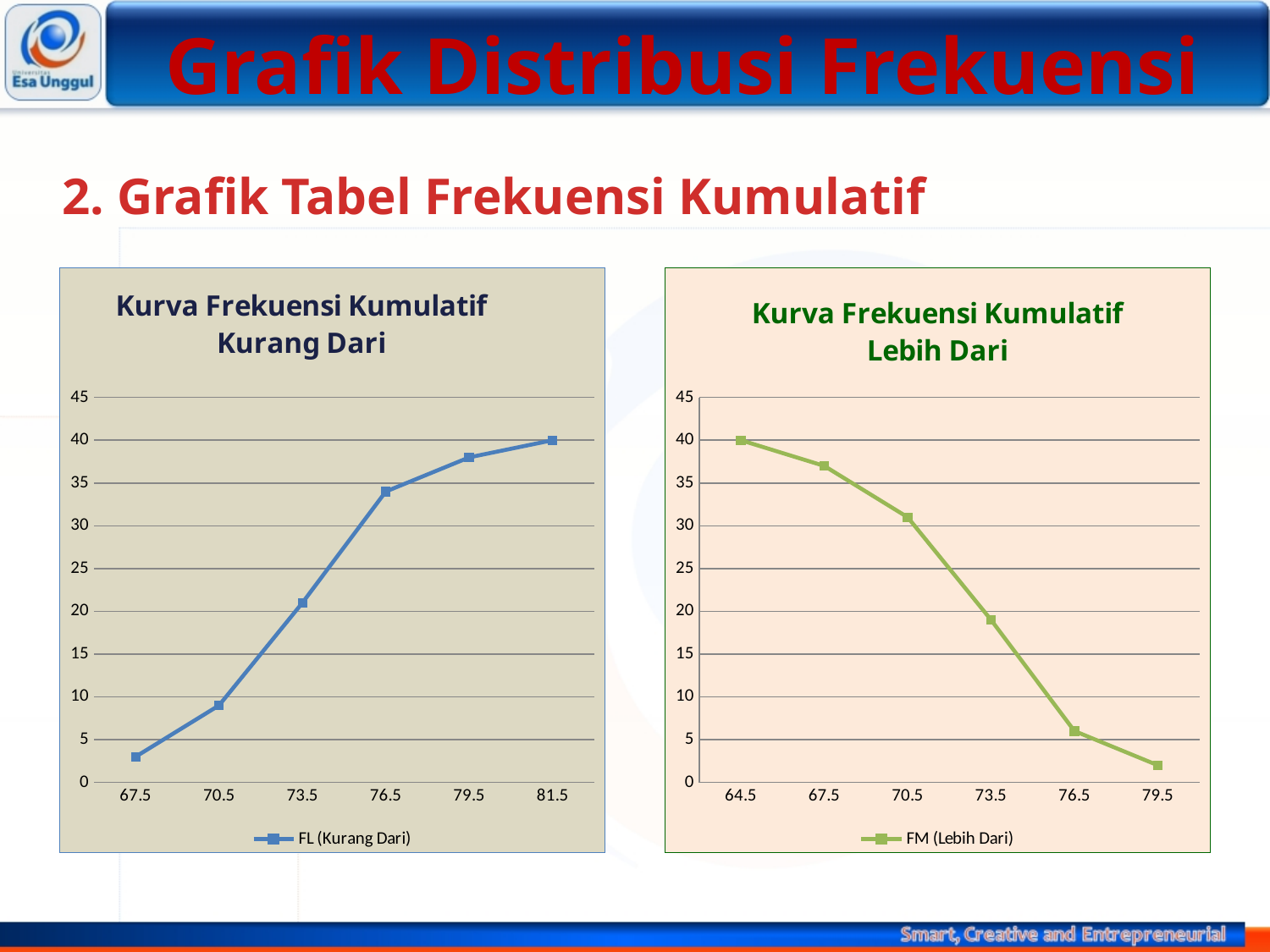
In the 'Kurva Frekuensi Kumulatif Kurang Dari' chart, is the value at 73.5 greater or less than 25? less In the 'Kurva Frekuensi Kumulatif Kurang Dari' chart, what is the value at 81.5? 40 In the 'Kurva Frekuensi Kumulatif Lebih Dari' chart, how many data points are plotted? 6 What kind of chart is the 'Kurva Frekuensi Kumulatif Kurang Dari' chart? line chart In the 'Kurva Frekuensi Kumulatif Kurang Dari' chart, which is larger, the value at 70.5 or the value at 76.5? 76.5 In the 'Kurva Frekuensi Kumulatif Lebih Dari' chart, which x-axis value has the lowest plotted value? 79.5 In the 'Kurva Frekuensi Kumulatif Lebih Dari' chart, is the value at 73.5 greater or less than 15? greater In the 'Kurva Frekuensi Kumulatif Kurang Dari' chart, do the values rise or fall as the x-axis values increase? rise In the 'Kurva Frekuensi Kumulatif Lebih Dari' chart, do the values rise or fall as the x-axis values increase? fall In the 'Kurva Frekuensi Kumulatif Lebih Dari' chart, what is the value at 64.5? 40 In the 'Kurva Frekuensi Kumulatif Kurang Dari' chart, how many data points are plotted? 6 What is the legend entry of the 'Kurva Frekuensi Kumulatif Lebih Dari' chart? FM (Lebih Dari)